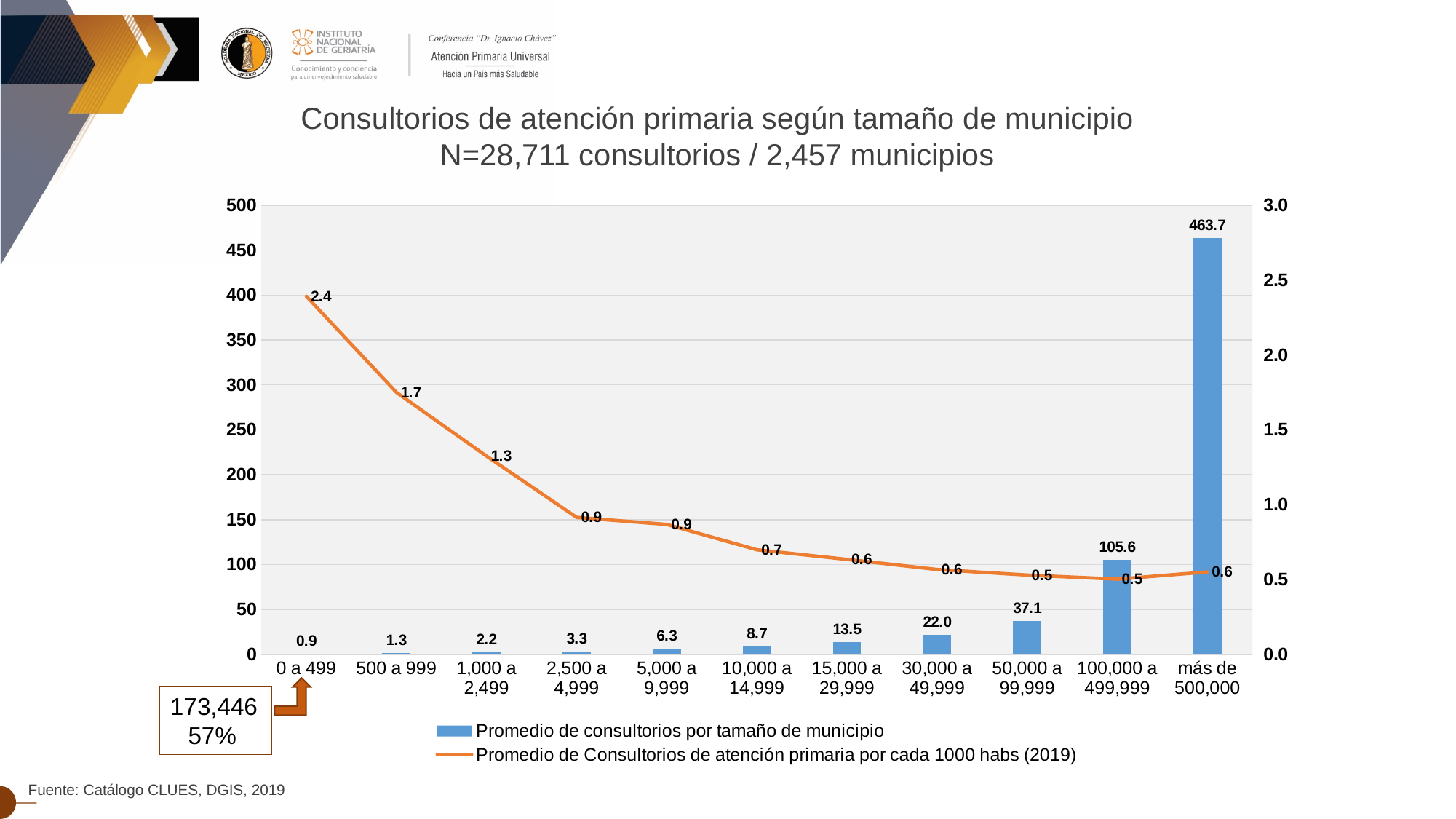
Which category has the lowest value in the bar series (Promedio de consultorios por tamaño de municipio)? 0 a 499 What is the value of the bar series for the '50,000 a 99,999' category? 37.1 What is the value of the line series (Promedio de Consultorios de atención primaria por cada 1000 habs) for the '0 a 499' category? 2.4 How many municipality size categories are shown on the x axis? 11 Does the line series (Promedio de Consultorios de atención primaria por cada 1000 habs) generally rise or fall from '0 a 499' to '50,000 a 99,999'? Fall What colour are the bars in the chart? Blue What is the difference between the bar values for 'más de 500,000' and '100,000 a 499,999'? 358.1 What kind of chart is shown on the slide? Combined bar and line chart How many series does the legend list? 2 Which category has the highest value in the bar series (Promedio de consultorios por tamaño de municipio)? más de 500,000 What is the value of the bar series (Promedio de consultorios por tamaño de municipio) for the 'más de 500,000' category? 463.7 In the line series, which is larger: the value for '500 a 999' or the value for '2,500 a 4,999'? 500 a 999